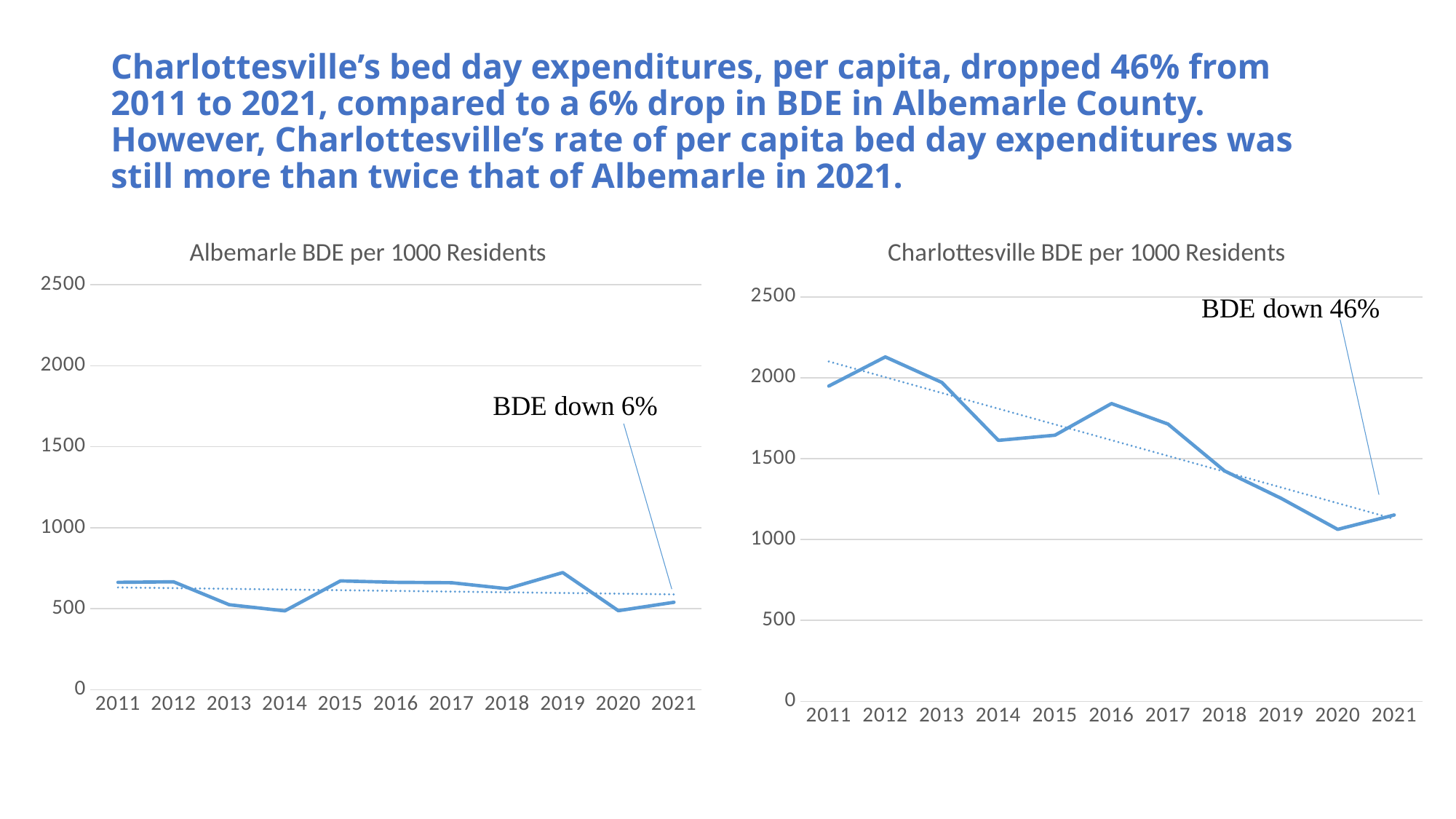
In the 'Albemarle BDE per 1000 Residents' chart, is the value for 2019 greater or less than 500? greater In the 'Charlottesville BDE per 1000 Residents' chart, is the value for 2012 greater or less than 2000? greater In the 'Charlottesville BDE per 1000 Residents' chart, do the values generally rise or fall from 2011 to 2021? fall What kind of chart is the 'Albemarle BDE per 1000 Residents' chart? line chart In the 'Charlottesville BDE per 1000 Residents' chart, which year has the lowest value? 2020 In the 'Charlottesville BDE per 1000 Residents' chart, which year has the larger value, 2014 or 2016? 2016 In the 'Charlottesville BDE per 1000 Residents' chart, which year has the highest value? 2012 In the 'Charlottesville BDE per 1000 Residents' chart, is the value for 2020 greater or less than 1500? less What does the annotation on the 'Charlottesville BDE per 1000 Residents' chart say? BDE down 46% How many years are plotted on the x axis of the 'Charlottesville BDE per 1000 Residents' chart? 11 In the 'Albemarle BDE per 1000 Residents' chart, which year has the highest value? 2019 In the 'Albemarle BDE per 1000 Residents' chart, which year has the larger value, 2013 or 2019? 2019